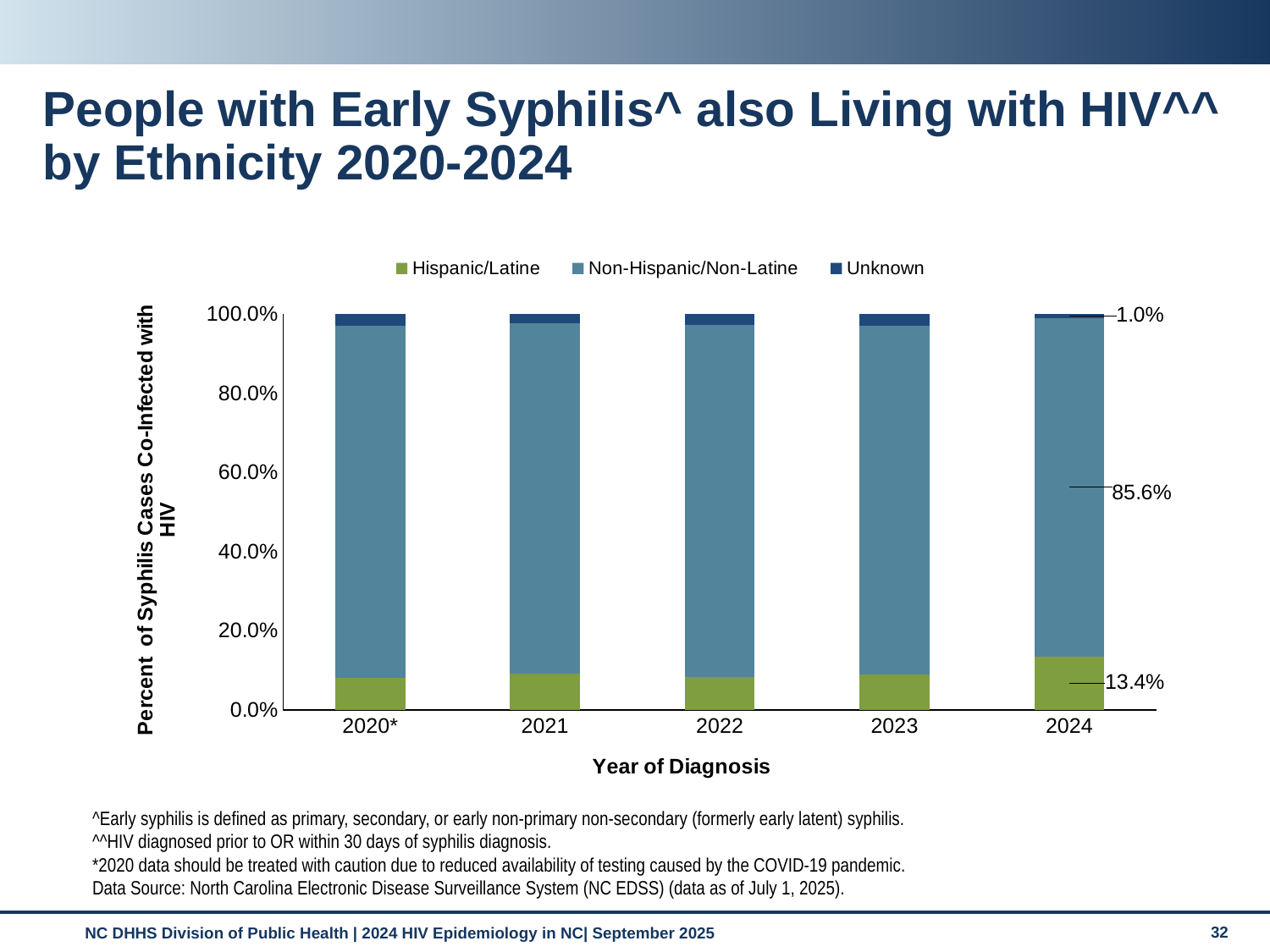
Which year has the largest Hispanic/Latine share? 2024 What percentage of early syphilis cases co-infected with HIV in 2024 were Non-Hispanic/Non-Latine? 85.6% What kind of chart is shown on the slide? Stacked bar chart In 2024, how much larger is the Non-Hispanic/Non-Latine share than the Hispanic/Latine share? 72.2% What percentage of early syphilis cases co-infected with HIV in 2024 had Unknown ethnicity? 1.0% Is the Hispanic/Latine share for 2020* greater or less than 20.0%? less How many ethnicity series does the legend list? 3 What is the total of the three labelled segments in the 2024 bar? 100.0% Is the Non-Hispanic/Non-Latine share for 2021 greater or less than 80.0%? greater What is the title of the x axis? Year of Diagnosis How many years of diagnosis are shown on the x axis? 5 What percentage of early syphilis cases co-infected with HIV in 2024 were Hispanic/Latine? 13.4%